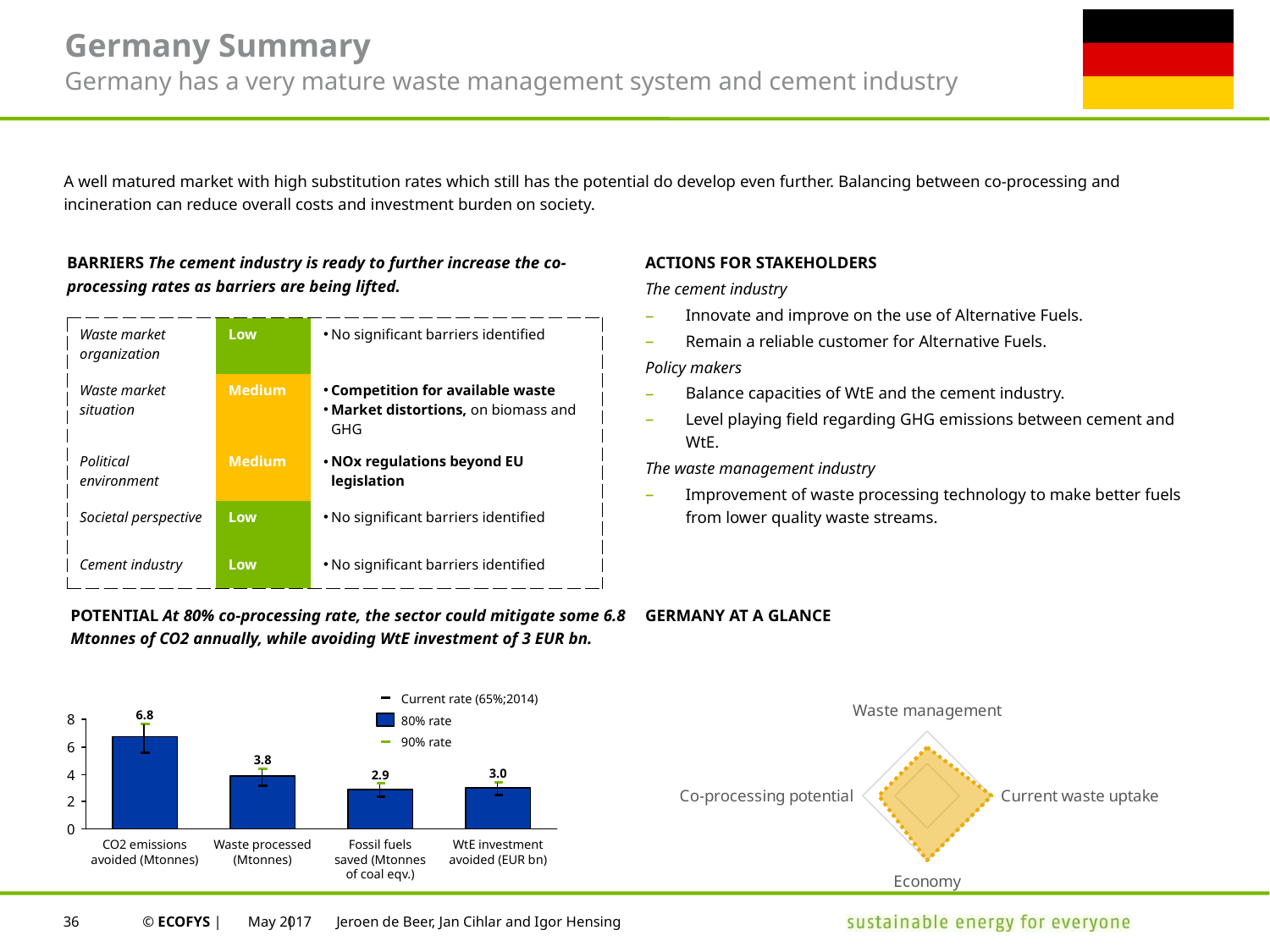
In the bar chart at the bottom left, which is larger: the labelled value for Waste processed or for Fossil fuels saved? Waste processed In the bar chart at the bottom left, is the bar for CO2 emissions avoided greater or less than 6? greater In the bar chart at the bottom left, which legend entry do the blue bars represent? 80% rate In the bar chart at the bottom left, which category has the lowest labelled value? Fossil fuels saved (Mtonnes of coal eqv.) What kind of chart is shown at the bottom left of the slide? Bar chart How many categories are shown on the x axis of the bar chart at the bottom left? 4 In the bar chart at the bottom left, which category has the highest labelled value? CO2 emissions avoided (Mtonnes) How many entries does the legend of the bar chart at the bottom left list? 3 In the bar chart at the bottom left, what is the value labelled for WtE investment avoided (EUR bn)? 3.0 In the bar chart at the bottom left, what is the value labelled for Waste processed (Mtonnes)? 3.8 In the bar chart at the bottom left, what is the difference between the labelled values for CO2 emissions avoided and Waste processed? 3.0 In the bar chart at the bottom left, what is the value labelled for CO2 emissions avoided (Mtonnes) at the 80% rate? 6.8